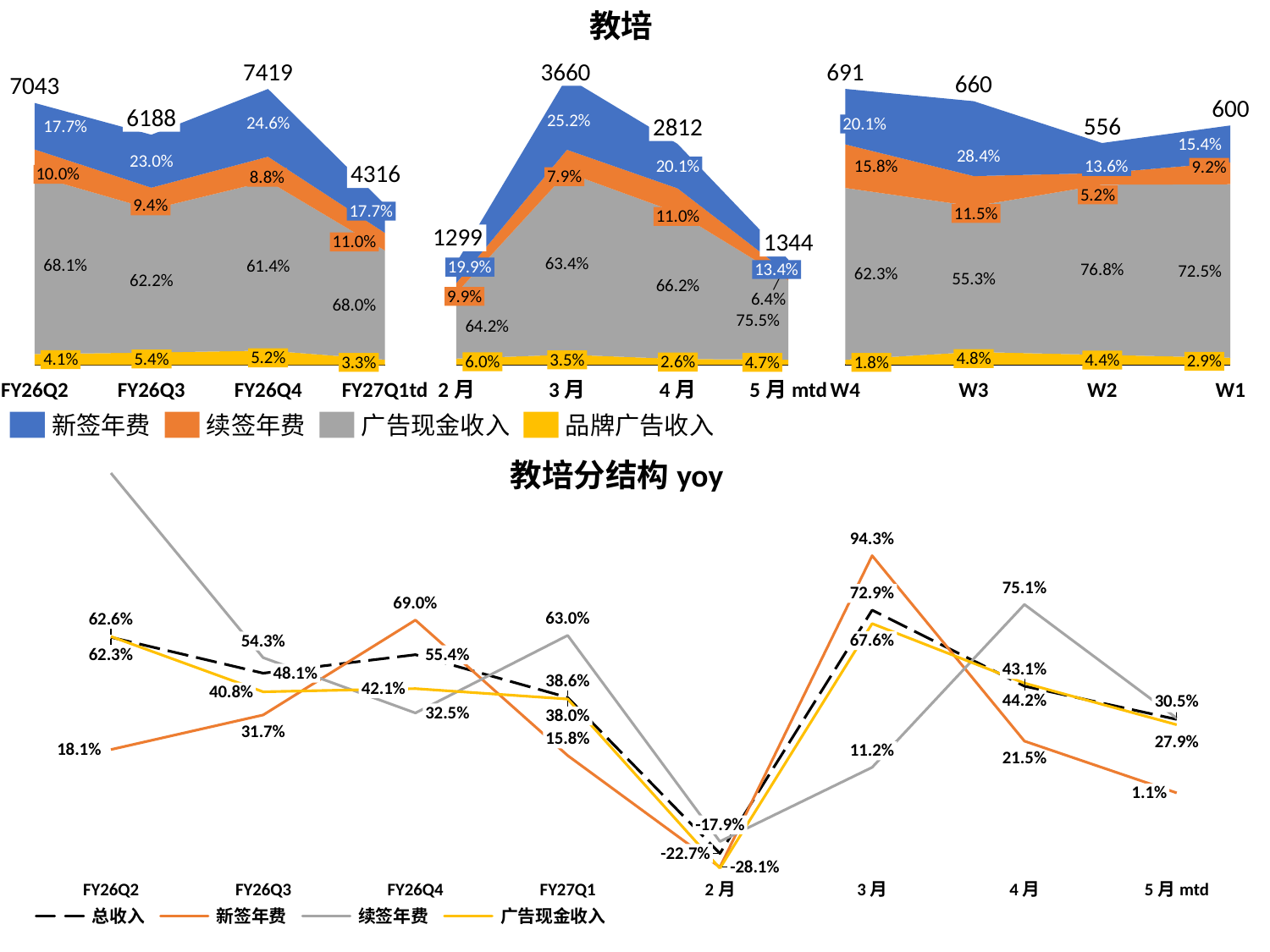
In the top chart titled 教培, what is the total value shown for FY26Q4? 7419 How many series does the legend of the top chart titled 教培 list? 4 In the bottom chart titled 教培分结构 yoy, which is larger at FY26Q4: 新签年费 or 续签年费? 新签年费 In the top chart titled 教培, what percentage share does 新签年费 have in 3月? 25.2% In the bottom chart titled 教培分结构 yoy, what is the 续签年费 value for 4月? 75.1% In the top chart titled 教培, what is the total value shown for 3月? 3660 In the top chart titled 教培, what percentage share does 广告现金收入 have in W2? 76.8% What kind of chart is the bottom chart titled 教培分结构 yoy? Line chart In the bottom chart titled 教培分结构 yoy, what is the 新签年费 value for 3月? 94.3% In the top chart titled 教培, what is the difference between the totals for FY26Q2 and FY26Q3? 855 In the top chart titled 教培, which of the quarterly periods (FY26Q2 to FY27Q1td) has the highest total? FY26Q4 In the top chart titled 教培, which of the weekly periods (W4 to W1) has the lowest total? W2